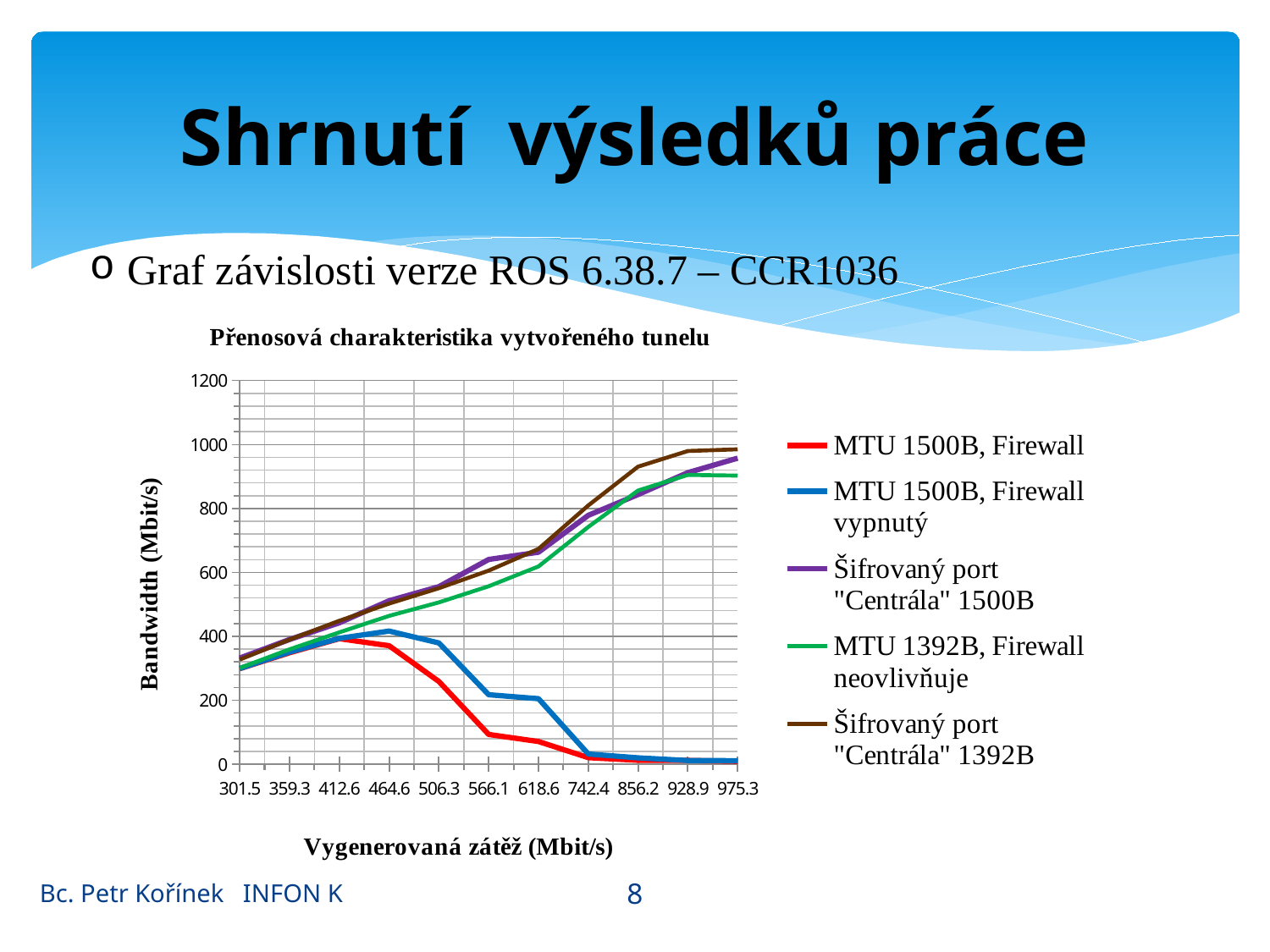
What is the title of the chart? Přenosová charakteristika vytvořeného tunelu Does the value for the series "Šifrovaný port "Centrála" 1392B" rise or fall along the x axis? rise What is the label of the y axis? Bandwidth (Mbit/s) At 618.6, which series has the larger value: "MTU 1500B, Firewall vypnutý" or "MTU 1500B, Firewall"? MTU 1500B, Firewall vypnutý What kind of chart is shown on the slide? line chart Is the value for "Šifrovaný port "Centrála" 1392B" at 975.3 greater or less than 800? greater Which series has the highest value at 856.2? Šifrovaný port "Centrála" 1392B Does the value for the series "MTU 1500B, Firewall" rise or fall as the generated load increases from 412.6 to 975.3? fall How many series does the legend list? 5 Is the value for "MTU 1392B, Firewall neovlivňuje" at 301.5 greater or less than 400? less How many points are marked on the x axis of the chart? 11 Is the value for "MTU 1500B, Firewall" at 975.3 greater or less than 200? less